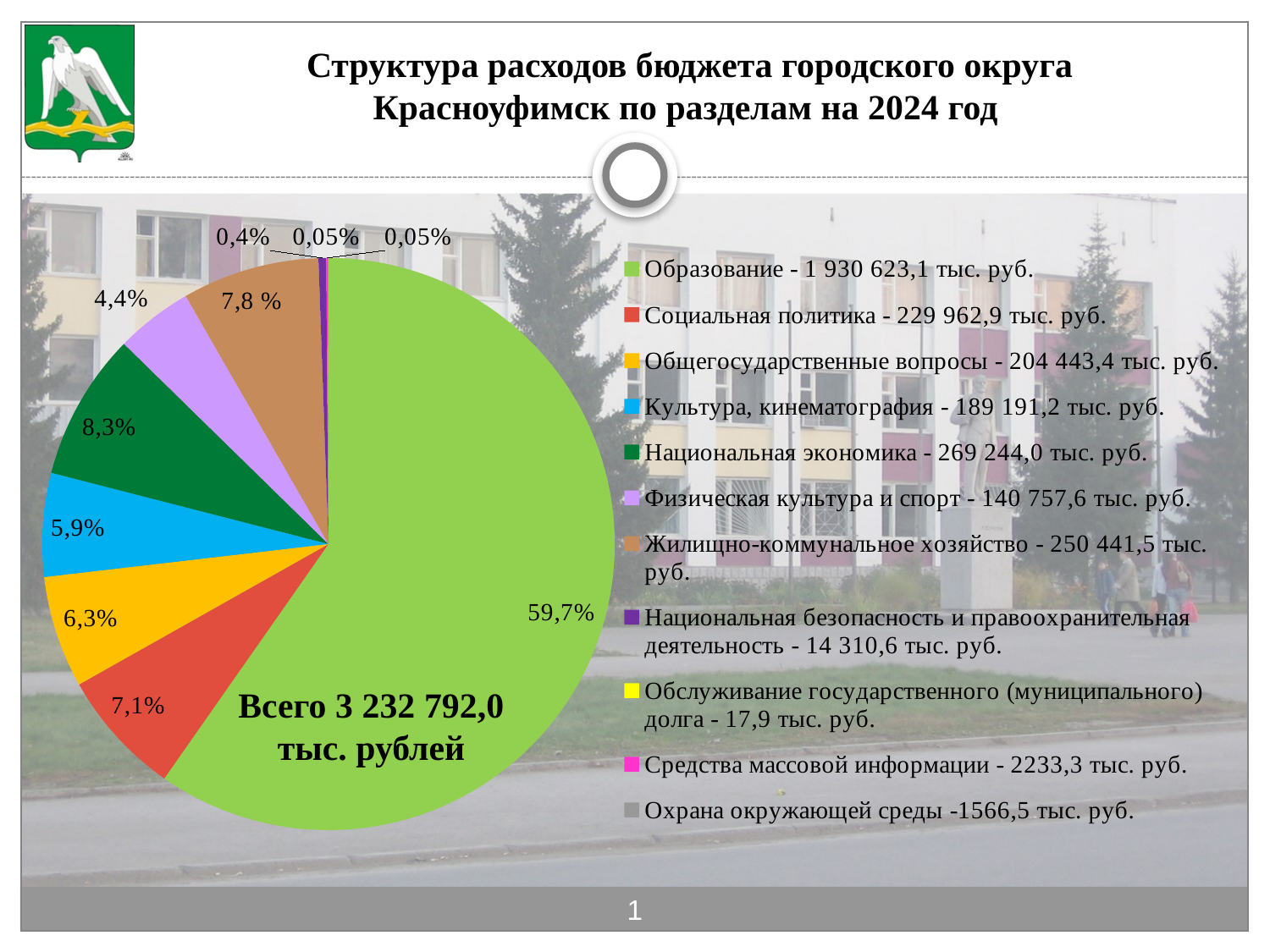
What is the total amount of expenditures shown on the chart? 3 232 792,0 тыс. рублей Which section has the largest share of the budget expenditures? Образование What share of the pie does Физическая культура и спорт take? 4,4% What is the value for Образование according to the legend? 1 930 623,1 тыс. руб. What is the difference between Социальная политика and Общегосударственные вопросы? 25 519,5 тыс. руб. What share of the pie does Национальная экономика take? 8,3% What kind of chart is shown on the slide? pie chart Which section has the smallest value in the legend? Обслуживание государственного (муниципального) долга What is the value for Социальная политика according to the legend? 229 962,9 тыс. руб. What share of the pie does Образование take? 59,7% Which is larger: Национальная экономика or Жилищно-коммунальное хозяйство? Национальная экономика How many sections does the legend list? 11